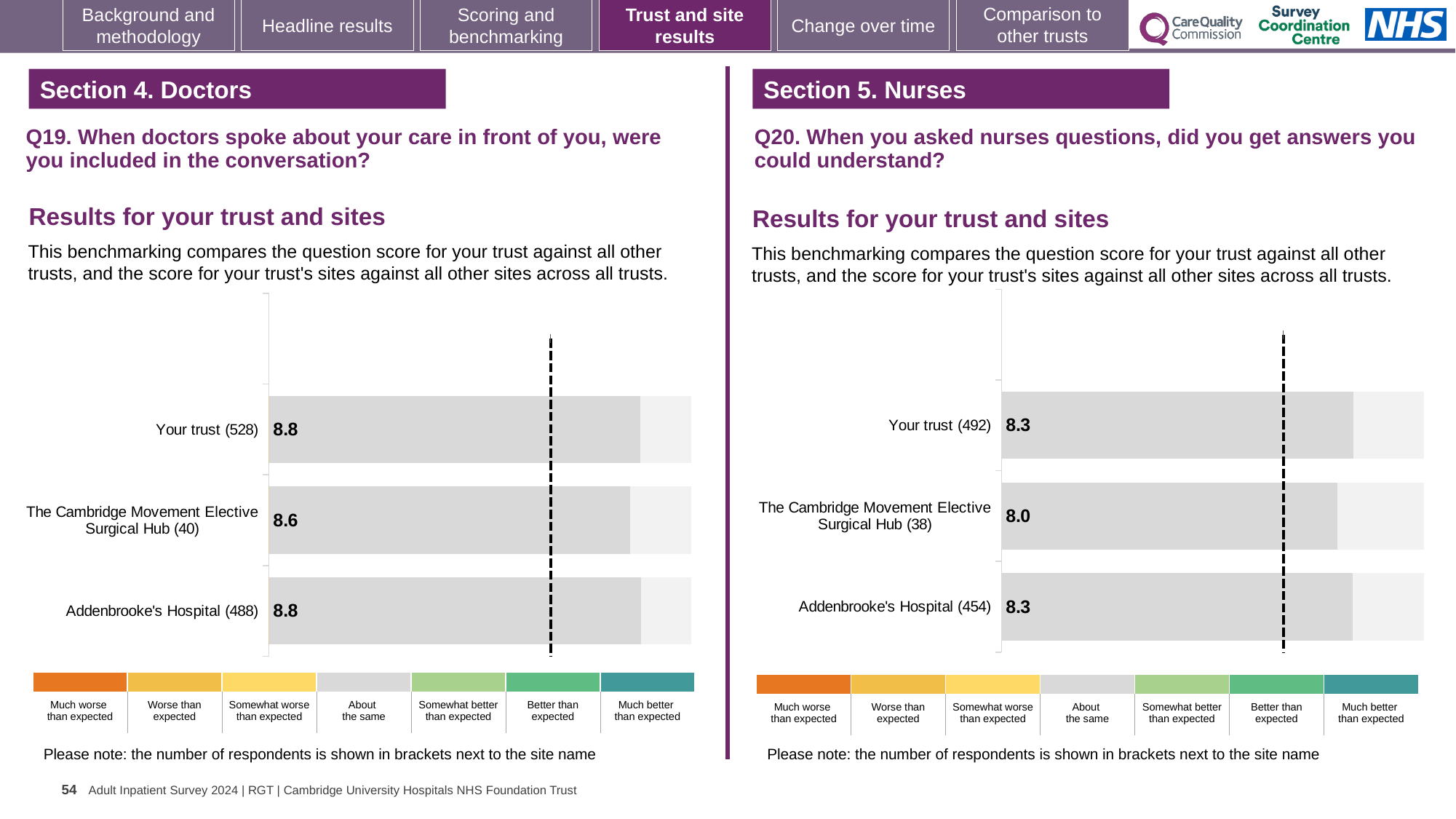
On the Q20 chart (right, Nurses), which has the higher score: Your trust or The Cambridge Movement Elective Surgical Hub? Your trust On the Q19 chart (left, Doctors), what is the difference between the score for Your trust and the score for The Cambridge Movement Elective Surgical Hub? 0.2 What kind of chart is used on the Q20 chart (right, Nurses)? Bar chart On the Q20 chart (right, Nurses), what is the score for The Cambridge Movement Elective Surgical Hub? 8.0 On the Q19 chart (left, Doctors), what is the score for The Cambridge Movement Elective Surgical Hub? 8.6 On the Q20 chart (right, Nurses), which site or trust has the lowest score? The Cambridge Movement Elective Surgical Hub On the Q19 chart (left, Doctors), how many respondents are shown in brackets for Addenbrooke's Hospital? 488 On the Q19 chart (left, Doctors), which site or trust has the lowest score? The Cambridge Movement Elective Surgical Hub On the Q19 chart (left, Doctors), what is the score for Your trust? 8.8 How many bars are plotted on the Q19 chart (left, Doctors)? 3 On the Q20 chart (right, Nurses), what is the score for Addenbrooke's Hospital? 8.3 On the Q20 chart (right, Nurses), what is the difference between the score for Addenbrooke's Hospital and the score for The Cambridge Movement Elective Surgical Hub? 0.3